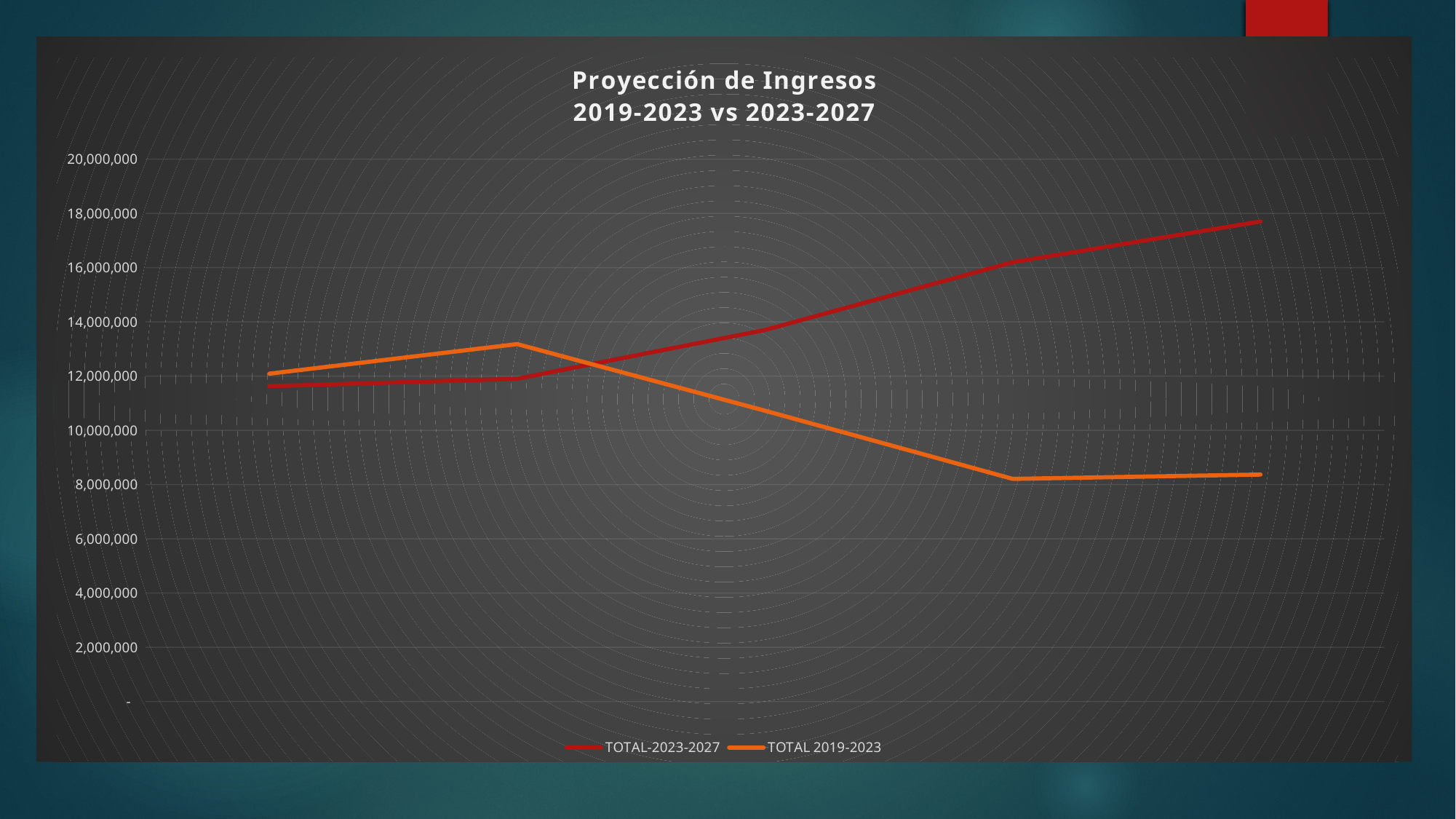
What is the title of the chart? Proyección de Ingresos 2019-2023 vs 2023-2027 Is the final value of the TOTAL 2019-2023 line greater or less than 10,000,000? less How many data points does each line have? 5 At the second point on the x axis, which series has the higher value? TOTAL 2019-2023 What kind of chart is shown on the slide? line chart Does the TOTAL-2023-2027 line rise or fall from left to right? rises At the last point on the x axis, which series has the higher value? TOTAL-2023-2027 Does the TOTAL 2019-2023 line rise or fall overall from its first point to its last point? falls How many series does the legend list? 2 Is the highest point of the TOTAL 2019-2023 line greater or less than 12,000,000? greater Which series reaches the highest value on the chart? TOTAL-2023-2027 Is the final value of the TOTAL-2023-2027 line greater or less than 16,000,000? greater